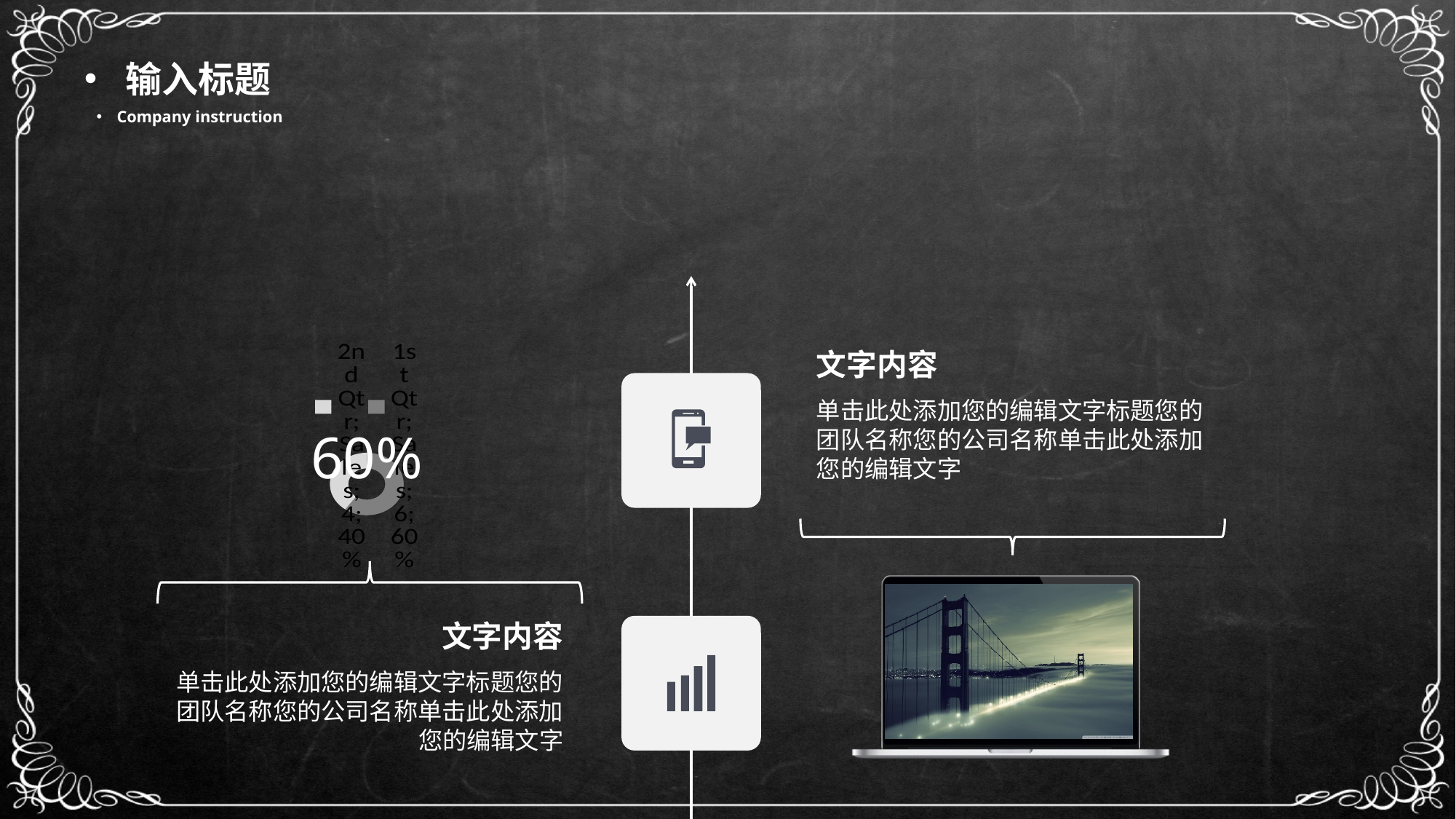
What large percentage label is displayed over the chart? 60% How many categories does the chart's legend list? 2 What share of the chart does 1st Qtr account for? 60% Which is larger, the share for 1st Qtr or the share for 2nd Qtr? 1st Qtr What is the name of the data series shown in the chart's legend? Sales What share of the chart does 2nd Qtr account for? 40% Which category has the smallest share of the chart? 2nd Qtr Which category has the largest share of the chart? 1st Qtr What is the difference between the values for 1st Qtr and 2nd Qtr? 2 What is the value for 1st Qtr in the chart? 6 What is the value for 2nd Qtr in the chart? 4 What kind of chart is shown on the slide? doughnut chart